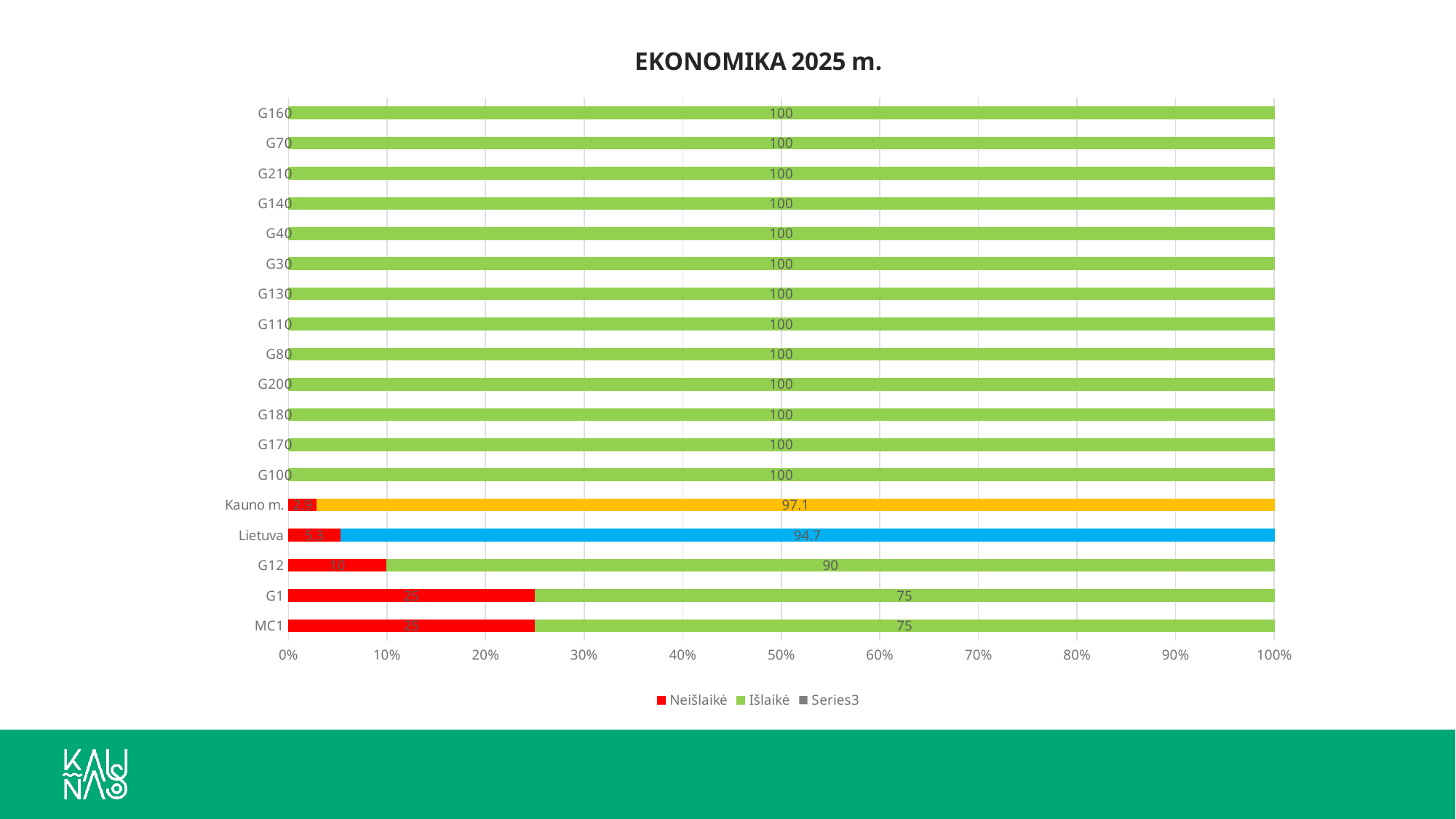
What kind of chart is shown on the slide? bar chart What is the difference between the Išlaikė values for Kauno m. and Lietuva? 2.4 What is the total of the stacked bar for G1? 100 How many categories are shown on the vertical axis? 18 What is the Neišlaikė value for Lietuva? 5.3 What is the Neišlaikė value for G1? 25 How many series does the legend list? 3 Which has the larger Neišlaikė value, G12 or MC1? MC1 What is the Išlaikė value for G12? 90 What is the Išlaikė value for Kauno m.? 97.1 What is the Išlaikė value for G100? 100 What is the title of the chart? EKONOMIKA 2025 m.